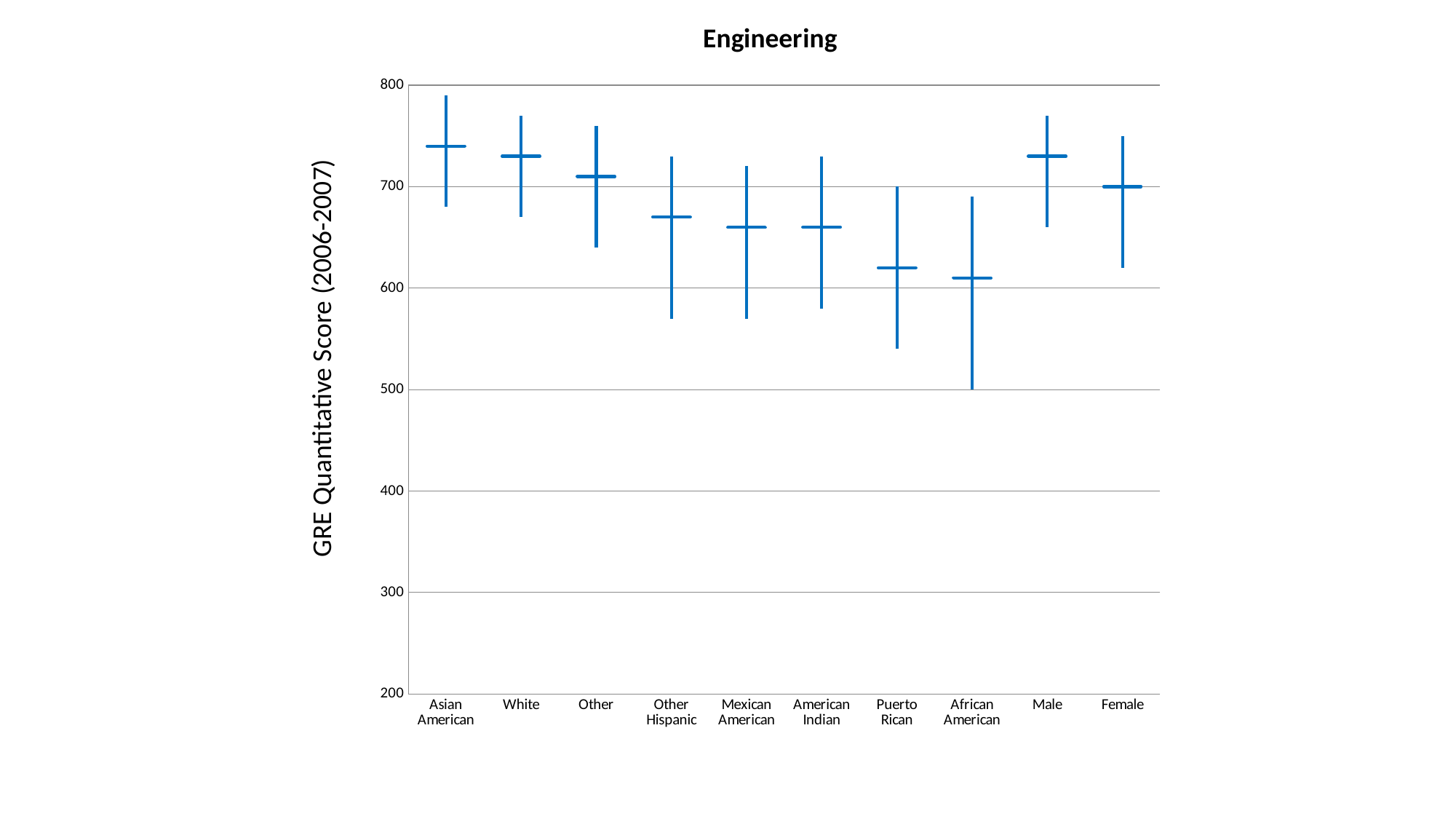
How many categories are shown on the horizontal axis? 10 Is the value for Male greater or less than 700? greater Which has the higher plotted score, Male or Female? Male What is the title of the chart? Engineering What is the GRE Quantitative Score plotted for Female? 700 What is the label on the vertical axis? GRE Quantitative Score (2006-2007) Is the value for African American greater or less than 600? greater Which has the higher plotted score, White or African American? White Which has the higher plotted score, Asian American or Puerto Rican? Asian American Is the value for Asian American greater or less than 700? greater